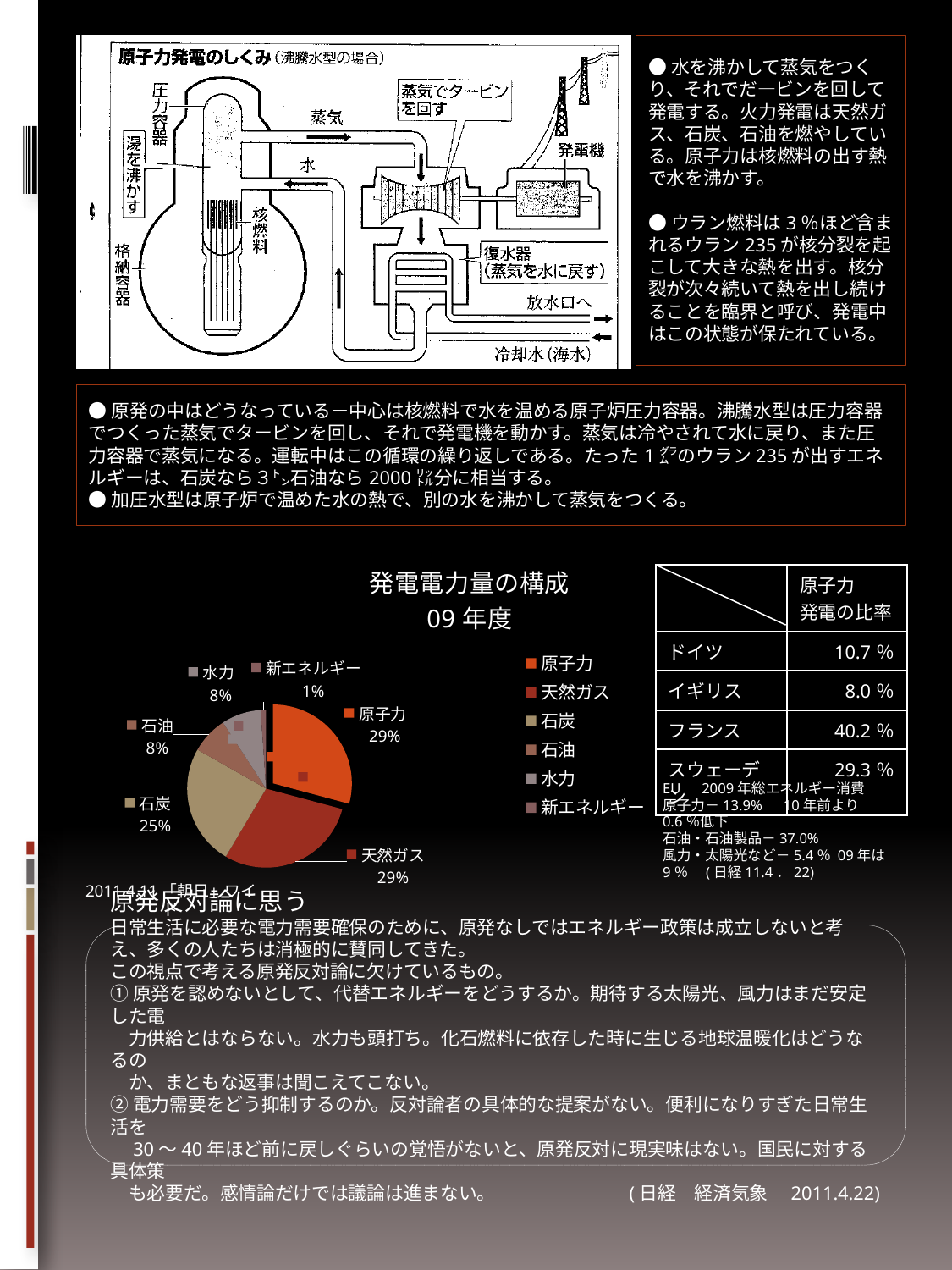
What is the value shown for 水力 in the pie chart? 8% Which category has the smallest slice in the pie chart? 新エネルギー What is the value shown for 天然ガス in the pie chart? 29% What is the difference in percentage points between 石炭 and 新エネルギー in the pie chart? 24 What kind of chart is shown on the slide under the title 発電電力量の構成 09年度? pie chart What is the title of the pie chart? 発電電力量の構成 09年度 How many categories does the pie chart show? 6 What share of the pie does 原子力 account for? 29% What is the value shown for 石炭 in the pie chart? 25% How many entries does the legend of the pie chart list? 6 Which is larger in the pie chart, 石炭 or 石油? 石炭 What is the value shown for 石油 in the pie chart? 8%